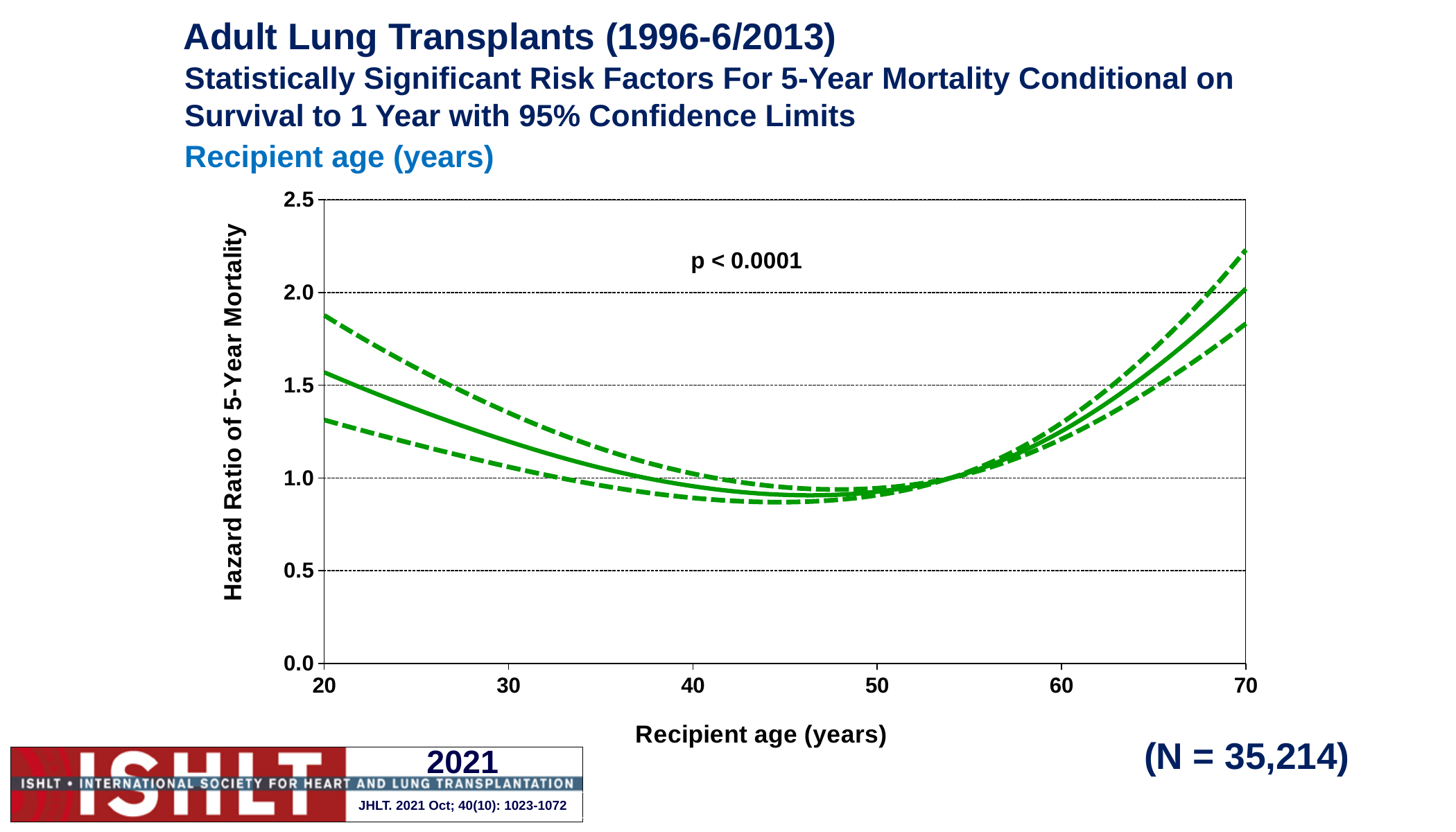
What kind of chart is shown on the slide? line chart Which recipient age has the higher hazard ratio on the solid line, 20 or 70? 70 What p-value is printed on the chart? p < 0.0001 Is the hazard ratio (solid line) at recipient age 20 greater or less than 1.0? greater Is the lower 95% confidence limit (lower dashed line) at recipient age 20 greater or less than 1.5? less Is the hazard ratio (solid line) at recipient age 45 greater or less than 1.0? less Does the hazard ratio (solid line) rise or fall as recipient age increases from 55 to 70? rise Does the hazard ratio (solid line) rise or fall as recipient age increases from 20 to 40? fall How many lines are plotted on the chart? 3